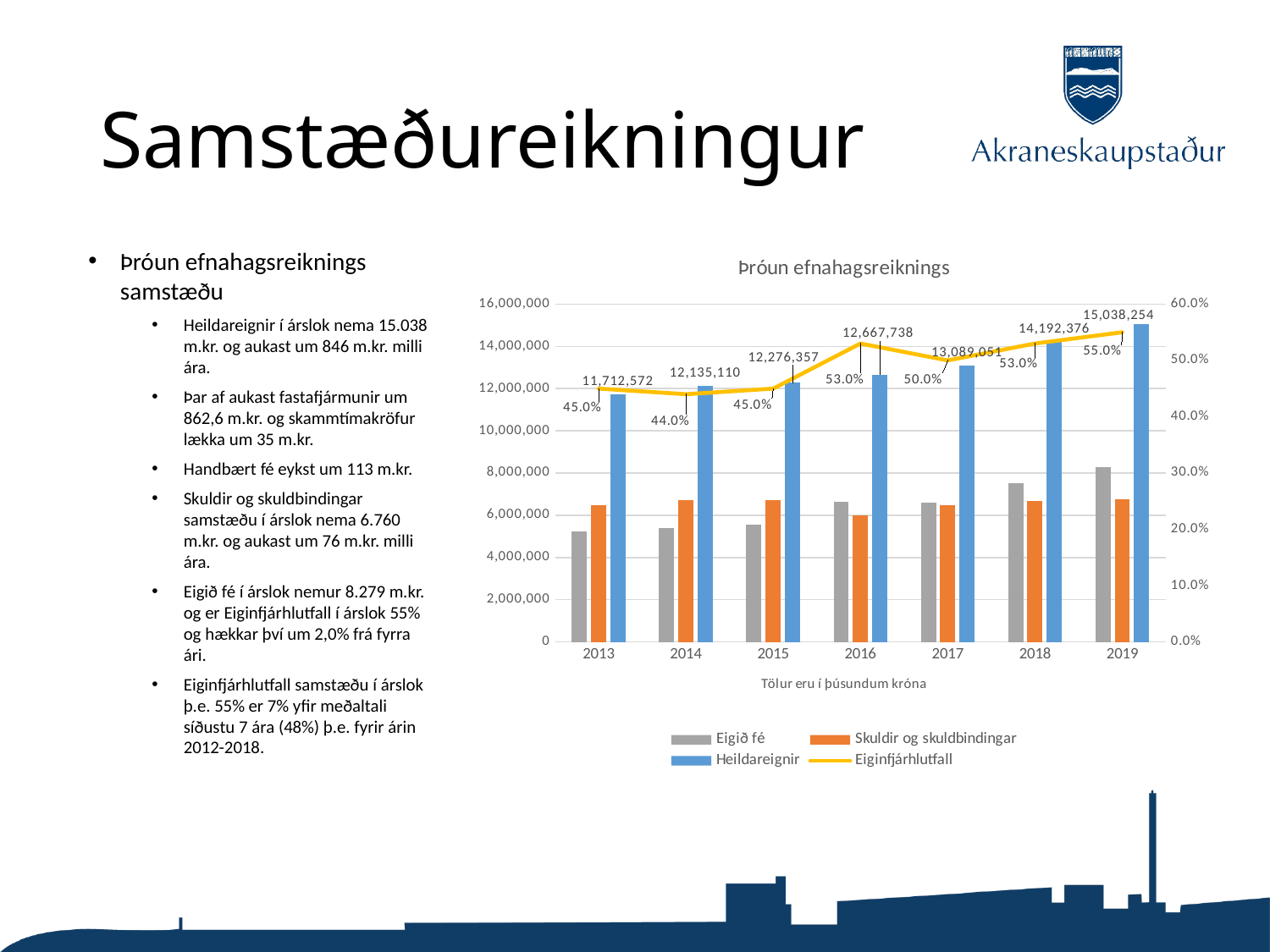
What is the value of Heildareignir in 2019? 15,038,254 Does Heildareignir rise or fall from 2013 to 2019? Rises What is the title of the chart? Þróun efnahagsreiknings What is the Eiginfjárhlutfall in 2016? 53.0% Is the value of Eigið fé in 2019 greater or less than 8,000,000? greater In which year is the Eiginfjárhlutfall lowest? 2014 What is the difference in Heildareignir between 2019 and 2018? 845,878 How many years are shown on the x axis of the chart? 7 What type of chart is shown on the slide? Combined bar and line chart How many series does the chart legend list? 4 What is the value of Heildareignir in 2013? 11,712,572 In which year is Heildareignir highest? 2019